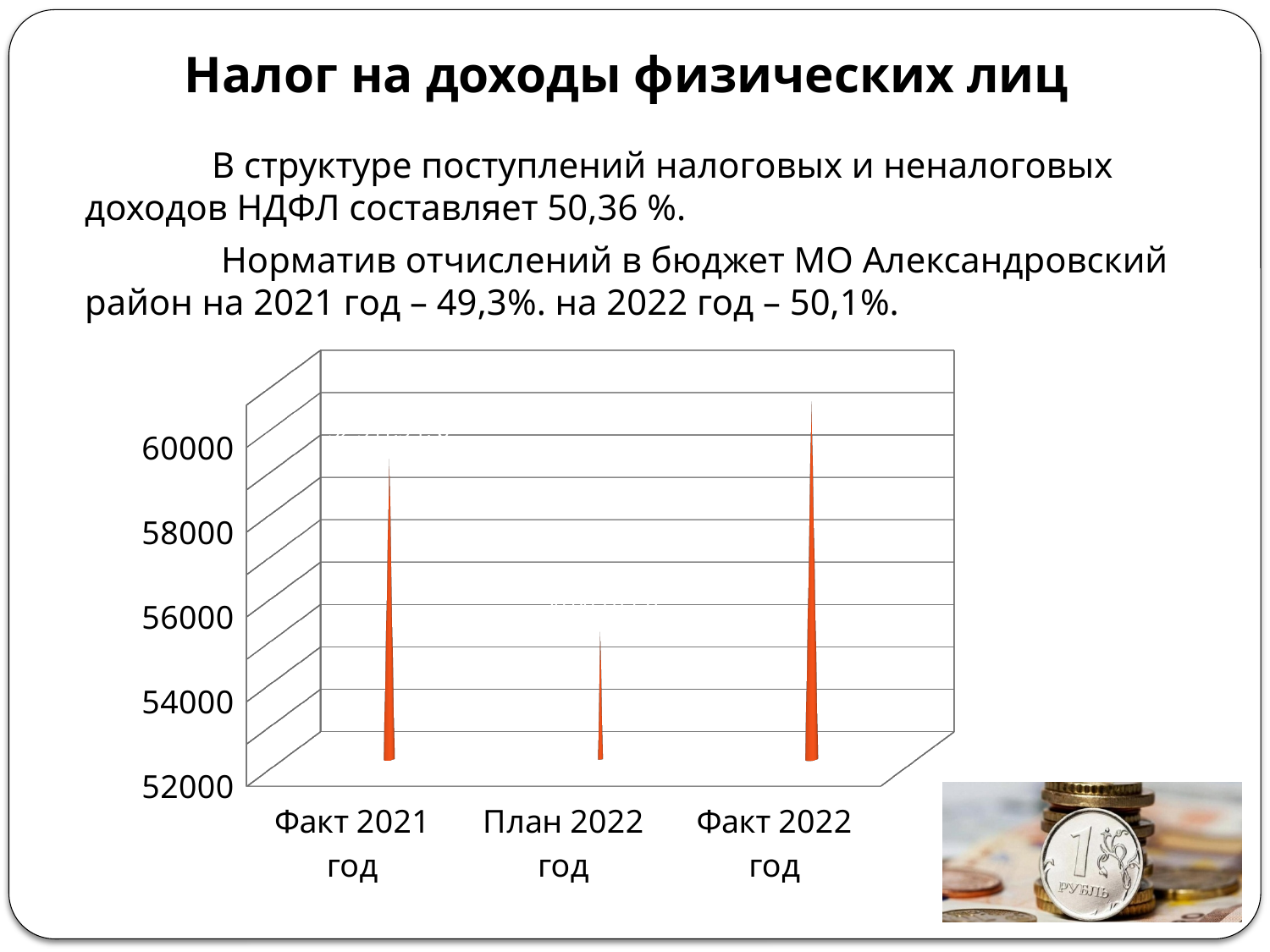
Which is larger, the value for Факт 2022 год or the value for Факт 2021 год? Факт 2022 год What is the highest tick label shown on the vertical axis of the chart? 60000 Which is larger, the value for Факт 2021 год or the value for План 2022 год? Факт 2021 год Which category has the lowest value in the chart? План 2022 год How many categories are shown on the x axis of the chart? 3 Does the value rise or fall from План 2022 год to Факт 2022 год? rises What is the lowest value shown on the vertical axis of the chart? 52000 Is the value for План 2022 год greater or less than 56000? less Is the value for Факт 2021 год greater or less than 56000? greater Which category has the highest value in the chart? Факт 2022 год What kind of chart is shown on the slide? bar chart Is the value for Факт 2022 год greater or less than 58000? greater